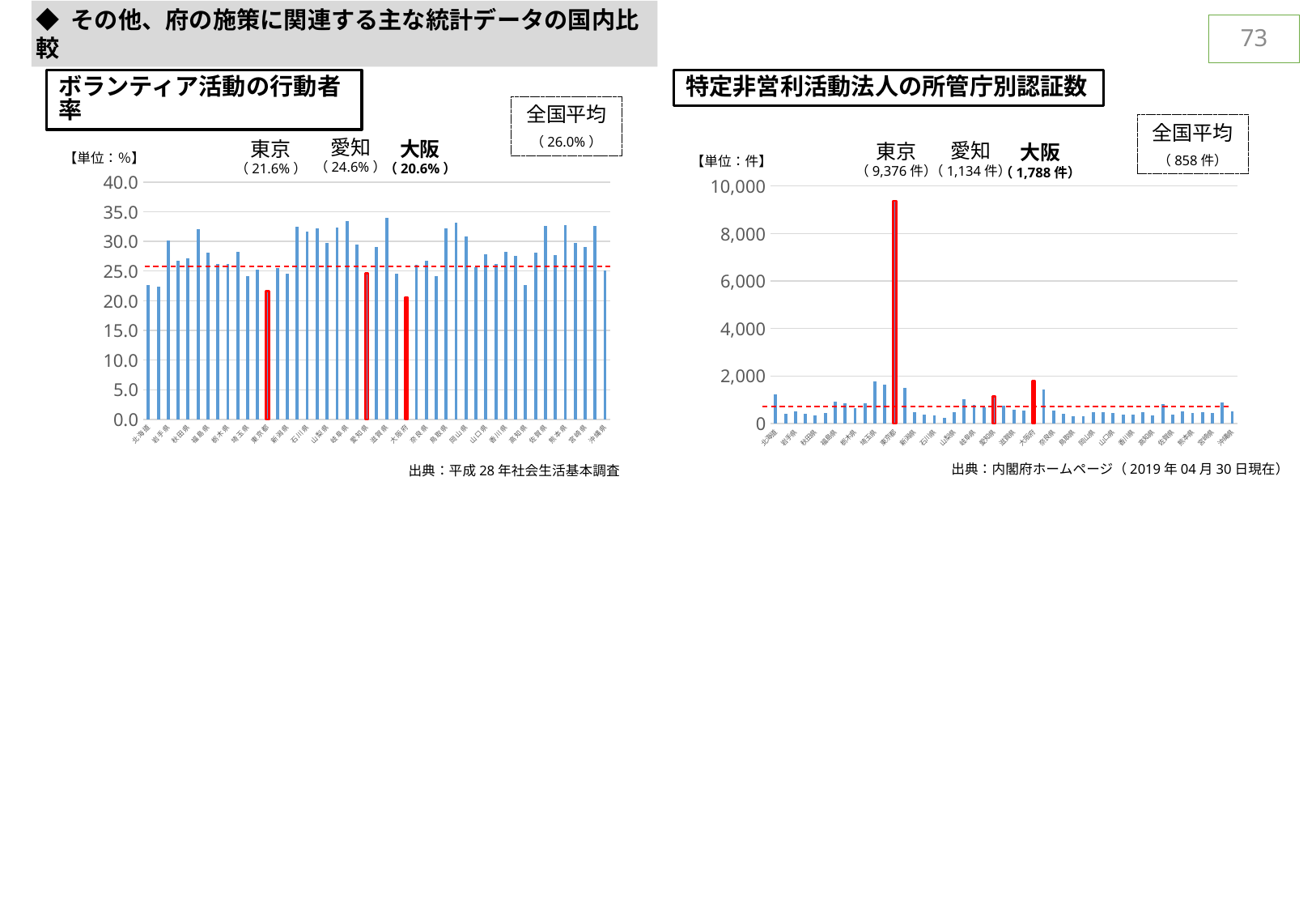
In the right chart (特定非営利活動法人の所管庁別認証数), which prefecture has the highest value? 東京都 In the right chart (特定非営利活動法人の所管庁別認証数), what is the difference between 東京 and 大阪? 7,588件 In the right chart (特定非営利活動法人の所管庁別認証数), what is the value for 大阪? 1,788件 In the left chart (ボランティア活動の行動者率), how much lower is 大阪 than the 全国平均? 5.4% In the left chart (ボランティア活動の行動者率), what is the 全国平均 (national average)? 26.0% In the left chart (ボランティア活動の行動者率), what is the value for 大阪? 20.6% In the right chart (特定非営利活動法人の所管庁別認証数), what is the value for 東京? 9,376件 In the right chart (特定非営利活動法人の所管庁別認証数), what does the red dashed horizontal line represent? 全国平均 (858件) In the left chart (ボランティア活動の行動者率), which is larger, the value for 愛知 or the value for 大阪? 愛知 In the right chart (特定非営利活動法人の所管庁別認証数), is the value for 北海道 greater or less than 2,000? less In the left chart (ボランティア活動の行動者率), what is the value for 東京? 21.6% What kind of chart is the left chart (ボランティア活動の行動者率)? bar chart